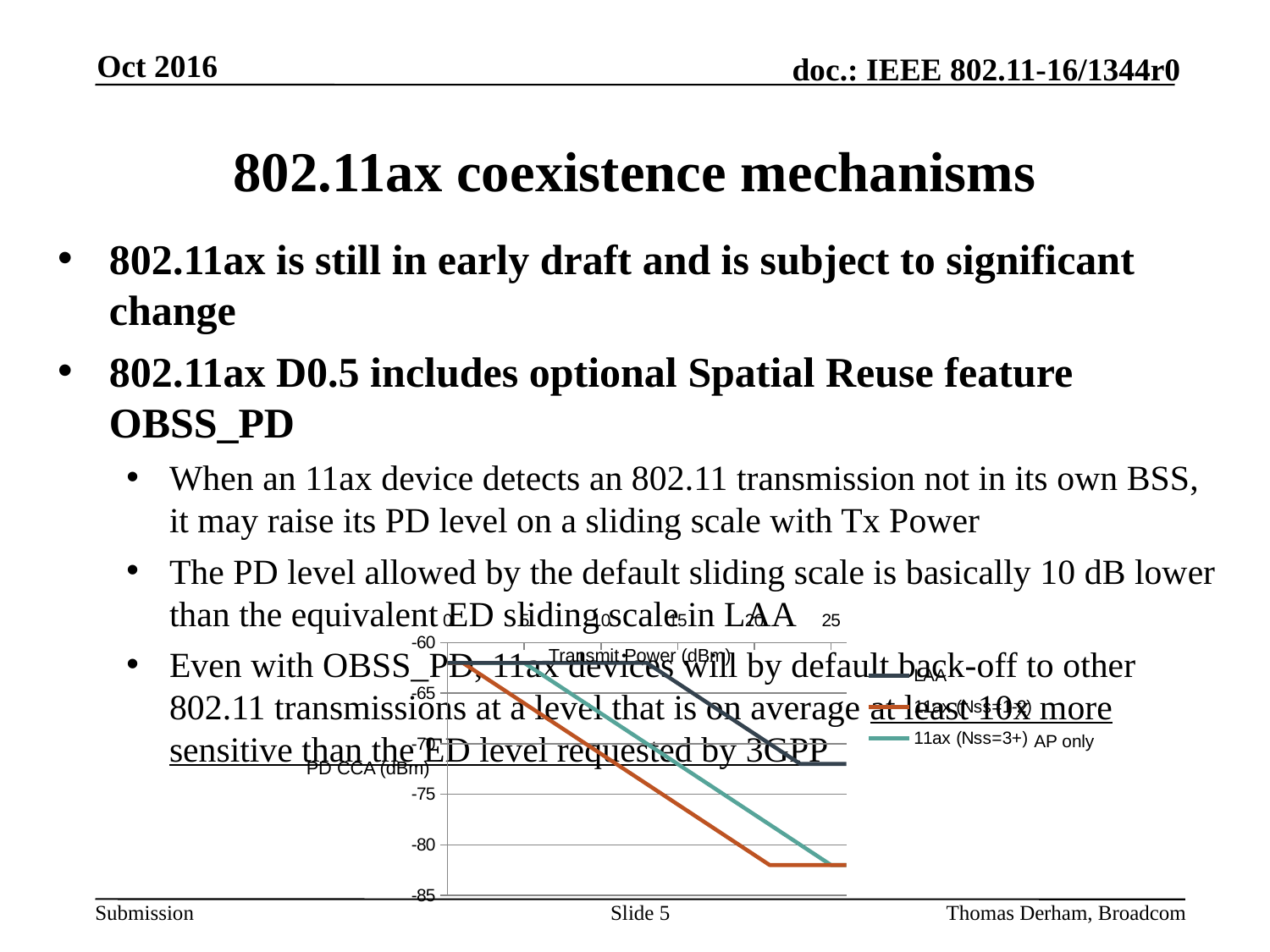
What is the title of the chart's x axis? Transmit Power (dBm) At a Transmit Power of 15 dBm, which series has the lowest PD CCA value? 11ax (Nss=1-2) At a Transmit Power of 25 dBm, is the LAA value greater or less than -75? greater What kind of chart is shown on the slide? line chart What is the title of the chart's y axis? PD CCA (dBm) At a Transmit Power of 25 dBm, is the 11ax (Nss=1-2) value greater or less than -75? less How many series does the chart legend list? 3 At a Transmit Power of 0 dBm, is the LAA value greater or less than -65? greater At a Transmit Power of 25 dBm, which series has the higher PD CCA value: LAA or 11ax (Nss=1-2)? LAA At a Transmit Power of 25 dBm, which series has the highest PD CCA value? LAA Do the plotted PD CCA values rise or fall as Transmit Power increases along the x axis? fall At a Transmit Power of 20 dBm, which series has the higher PD CCA value: 11ax (Nss=3+) AP only or 11ax (Nss=1-2)? 11ax (Nss=3+) AP only